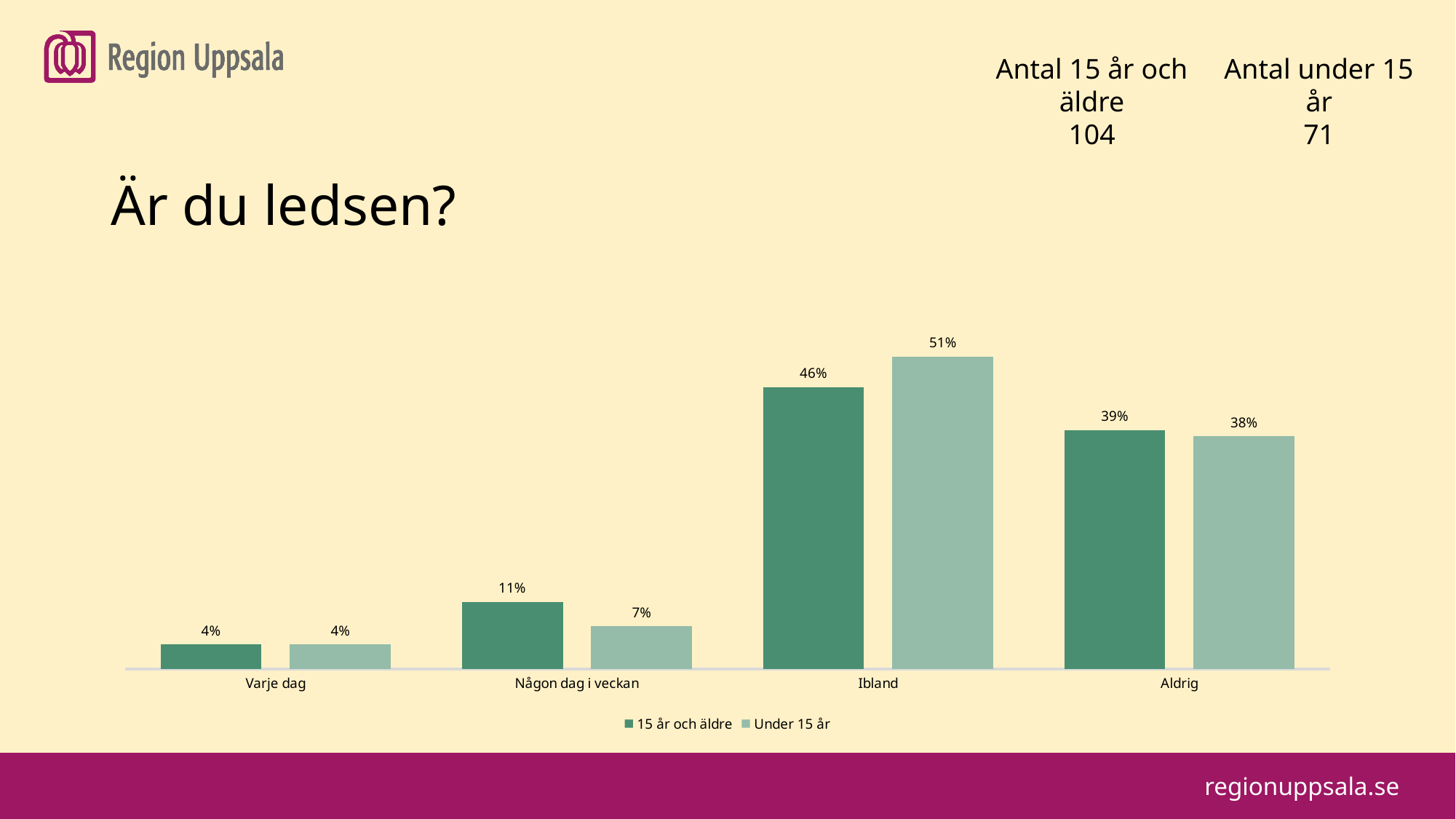
What is the difference between the "Under 15 år" and "15 år och äldre" values in the "Ibland" category? 5% Which category has the highest value for the "Under 15 år" series? Ibland Which category has the lowest value for the "15 år och äldre" series? Varje dag What is the difference between the "15 år och äldre" and "Under 15 år" values in the "Någon dag i veckan" category? 4% In the "Någon dag i veckan" category, which series has the larger value? 15 år och äldre How many series does the legend list? 2 What is the title of the slide above the chart? Är du ledsen? What is the value for "Under 15 år" in the "Aldrig" category? 38% How many categories are shown on the x axis? 4 What kind of chart is shown on the slide? Bar chart What is the value for "Under 15 år" in the "Någon dag i veckan" category? 7% What is the value for "15 år och äldre" in the "Ibland" category? 46%